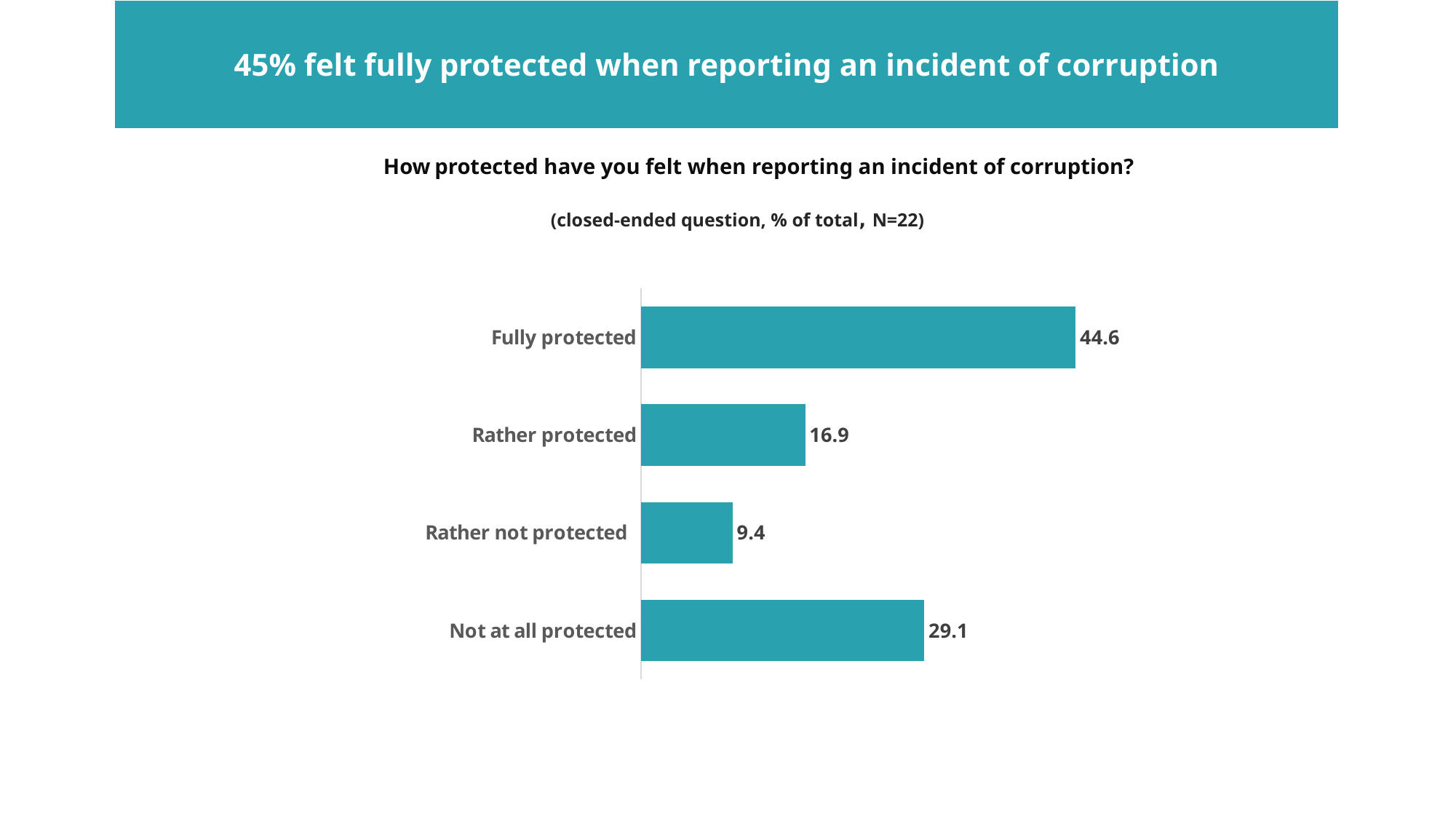
Which is larger, the value for "Rather protected" or the value for "Not at all protected"? Not at all protected What kind of chart is shown on the slide? Bar chart What is the difference between the values for "Rather protected" and "Rather not protected"? 7.5 Which category has the lowest value? Rather not protected What is the value for "Fully protected"? 44.6 What is the value for "Rather protected"? 16.9 What is the value for "Not at all protected"? 29.1 What is the value for "Rather not protected"? 9.4 What is the sample size (N) stated in the chart subtitle? N=22 How many categories are shown in the chart? 4 What is the difference between the values for "Fully protected" and "Not at all protected"? 15.5 Which category has the highest value? Fully protected